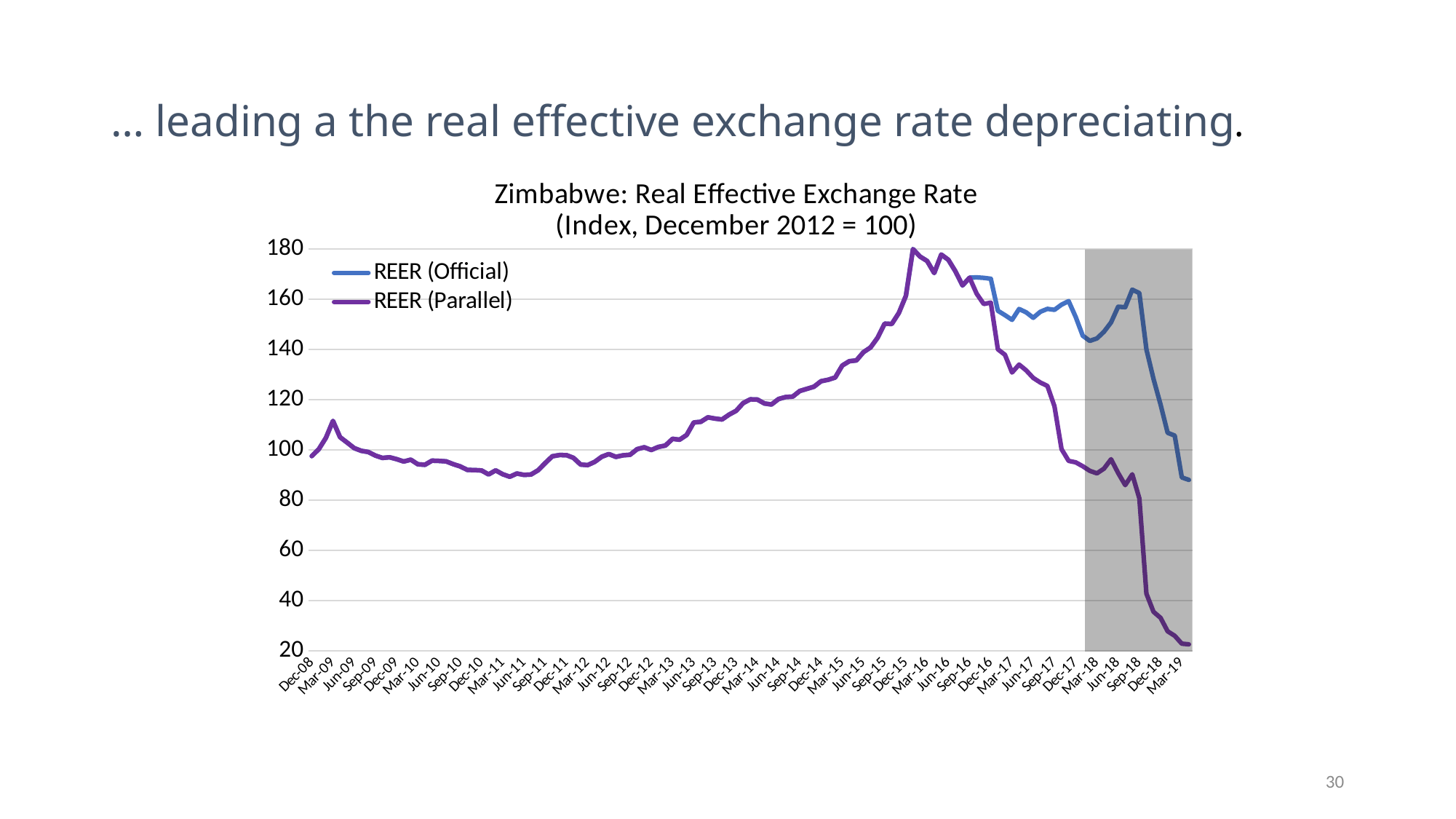
At Mar-19, which series has the higher value, REER (Official) or REER (Parallel)? REER (Official) Is the value of REER (Official) at Mar-19 greater or less than 100? less Does REER (Parallel) rise or fall between Dec-15 and Mar-19? fall Is the value of REER (Parallel) at Mar-09 greater or less than 100? greater How many series does the legend list? 2 What kind of chart is shown on the slide? line chart Is the value of REER (Parallel) at Mar-19 greater or less than 40? less What is the title of the chart? Zimbabwe: Real Effective Exchange Rate (Index, December 2012 = 100) What are the two series named in the legend? REER (Official) and REER (Parallel)